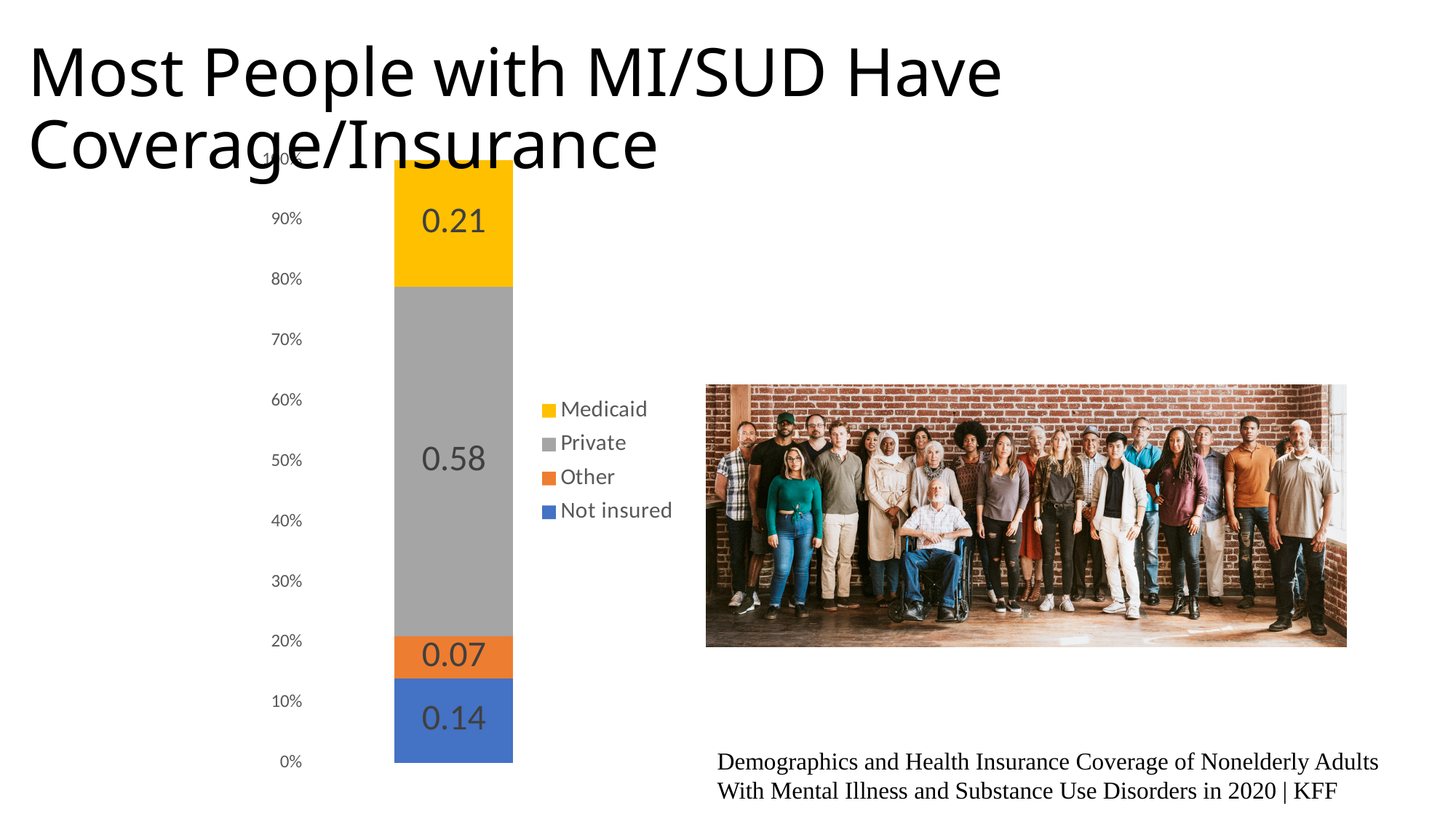
What is the value of the Not insured segment in the stacked bar? 0.14 What kind of chart is shown on the slide? Stacked bar chart What is the value of the Other segment in the stacked bar? 0.07 What is the difference between the Private and Medicaid values? 0.37 Which is larger, the Medicaid value or the Not insured value? Medicaid Which series has the smallest segment in the stacked bar? Other What is the value of the Medicaid segment in the stacked bar? 0.21 Which series has the largest segment in the stacked bar? Private How many series does the legend list? 4 What is the value of the Private segment in the stacked bar? 0.58 What colour represents Medicaid in the chart? Yellow What is the difference between the Not insured and Other values? 0.07